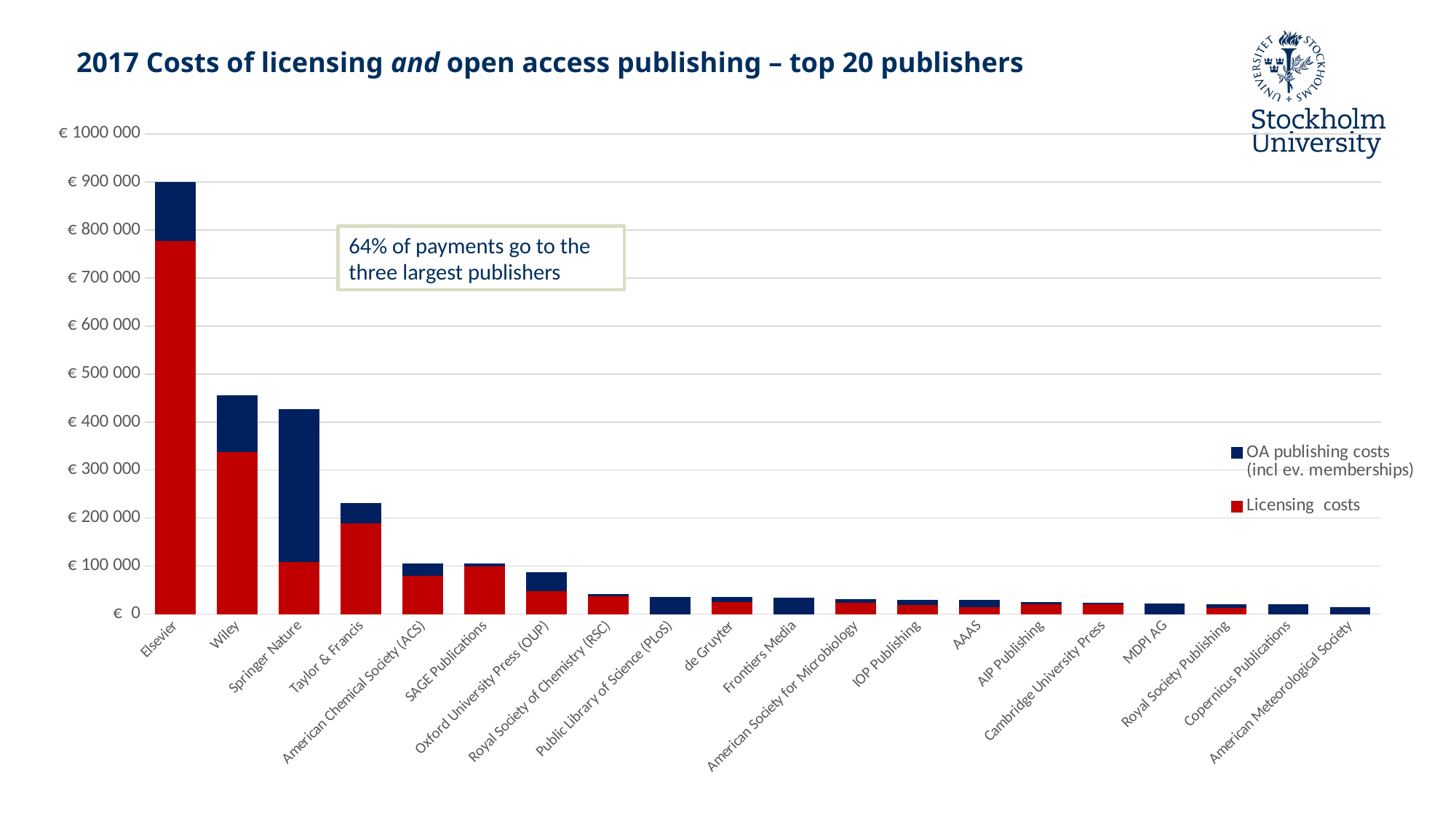
According to the text box on the chart, what share of payments goes to the three largest publishers? 64% What kind of chart is shown on the slide? Stacked bar chart Which publisher has the lowest total cost in the chart? American Meteorological Society Which publisher has the highest total cost in the chart? Elsevier Which has the larger OA publishing costs, Springer Nature or Wiley? Springer Nature How many publishers are shown on the x axis of the chart? 20 Do the total costs rise or fall moving from left to right along the x axis? fall Are the licensing costs for Wiley greater or less than € 300 000? greater Is the total cost for Elsevier greater or less than € 800 000? greater Is the total cost for Oxford University Press (OUP) greater or less than € 100 000? less How many series does the chart's legend list? 2